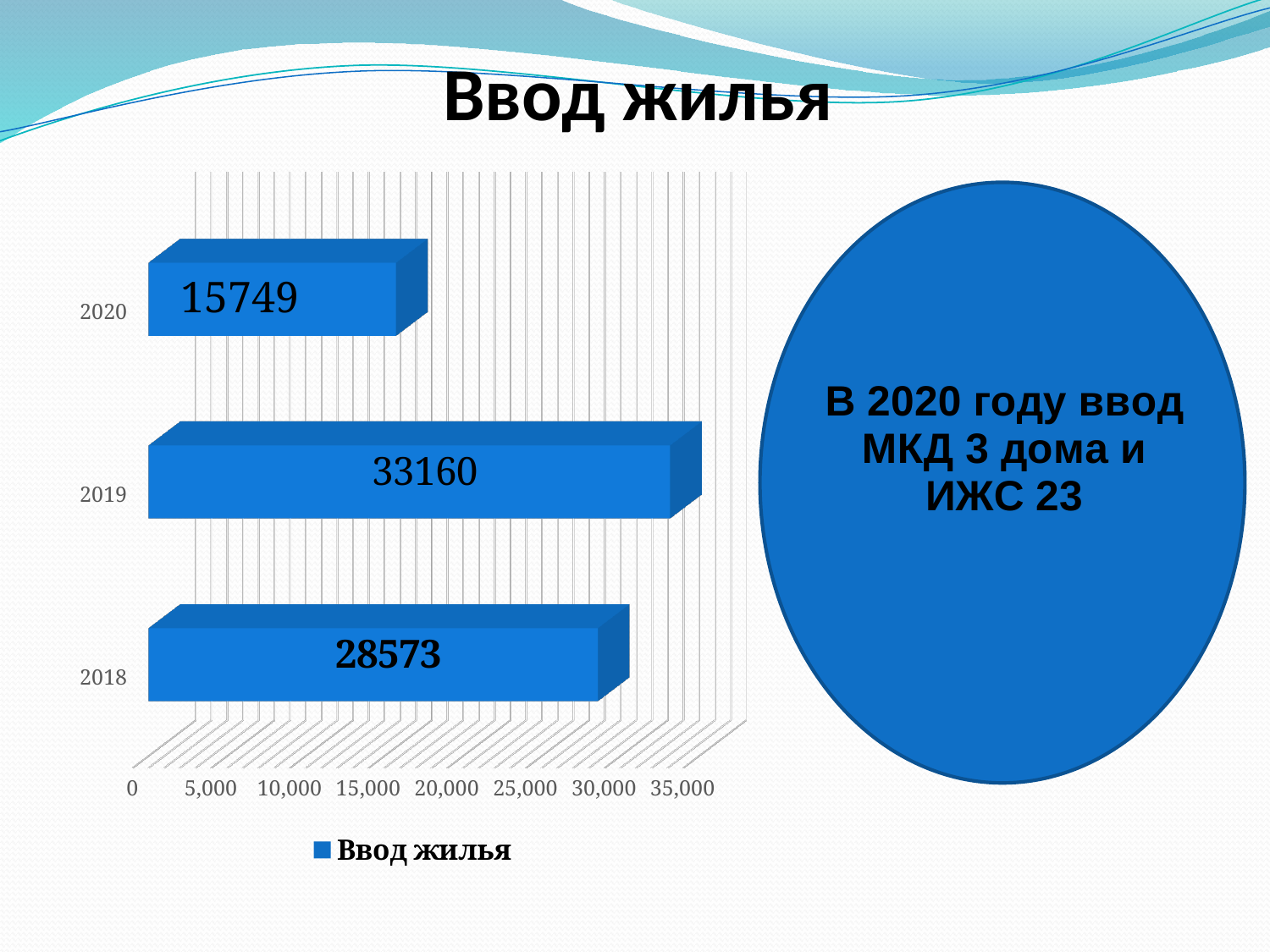
Which year has the highest value in the chart? 2019 What is the difference between the values for 2018 and 2020? 12824 What kind of chart is shown on the slide? bar chart Which year has the lowest value in the chart? 2020 What is the legend entry of the chart? Ввод жилья How many years are shown in the chart? 3 What is the value for 2020 in the chart? 15749 What is the value for 2019 in the chart? 33160 Is the value for 2019 greater or less than 30,000? greater What is the value for 2018 in the chart? 28573 What is the difference between the values for 2019 and 2018? 4587 Which is larger, the value for 2018 or the value for 2020? 2018